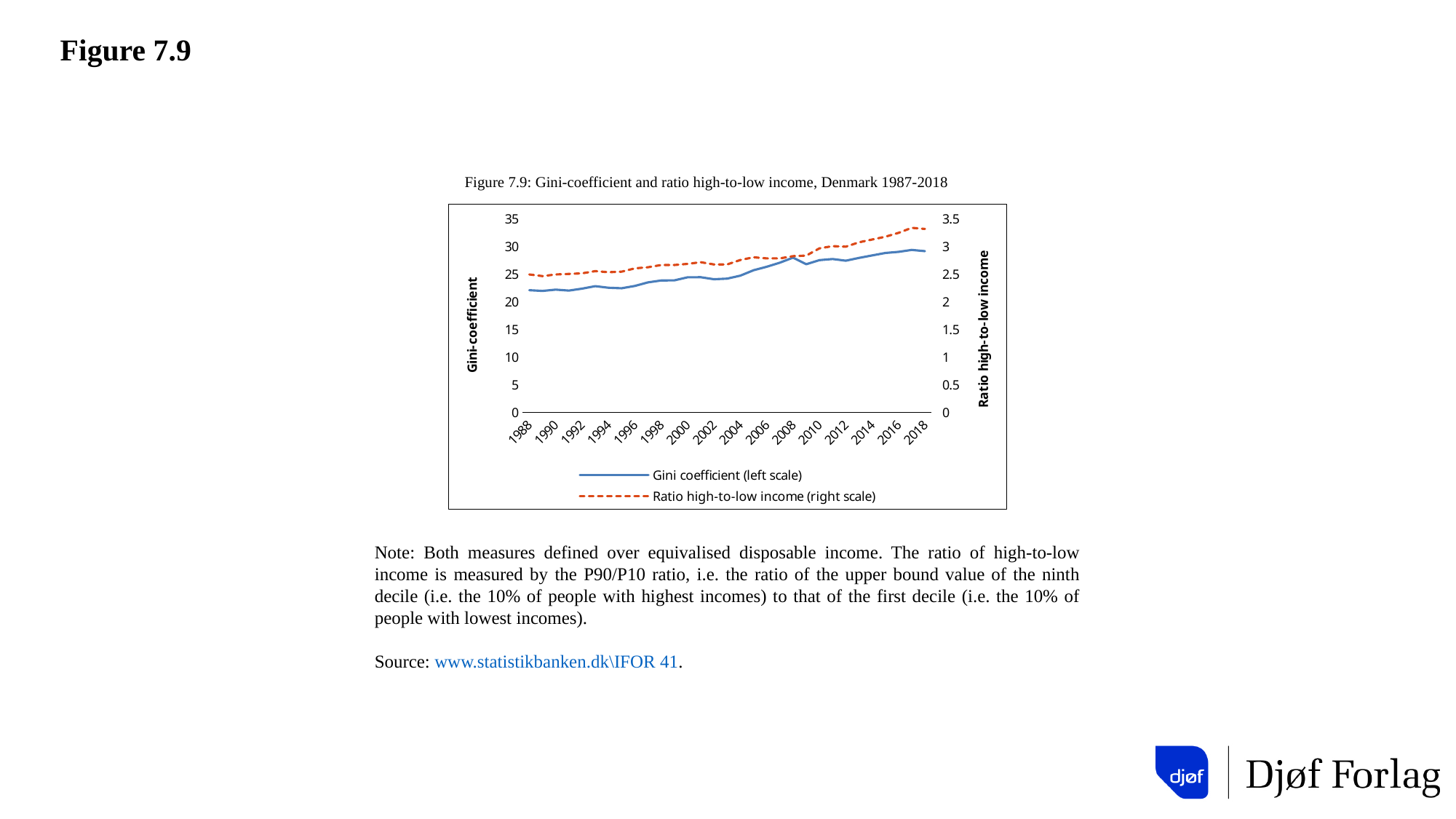
Is the ratio high-to-low income value for 1988 greater or less than 2? greater Is the Gini coefficient value for 2018 greater or less than 25? greater Which series is plotted with a dashed line? Ratio high-to-low income (right scale) Is the Gini coefficient value for 2000 greater or less than 20? greater Does the ratio high-to-low income generally rise or fall from 1988 to 2018? Rise What is the title of the chart? Figure 7.9: Gini-coefficient and ratio high-to-low income, Denmark 1987-2018 How many series does the legend list? 2 Does the Gini coefficient generally rise or fall from 1988 to 2018? Rise What kind of chart is shown on the slide? Line chart Is the Gini coefficient higher in 2018 or in 1988? 2018